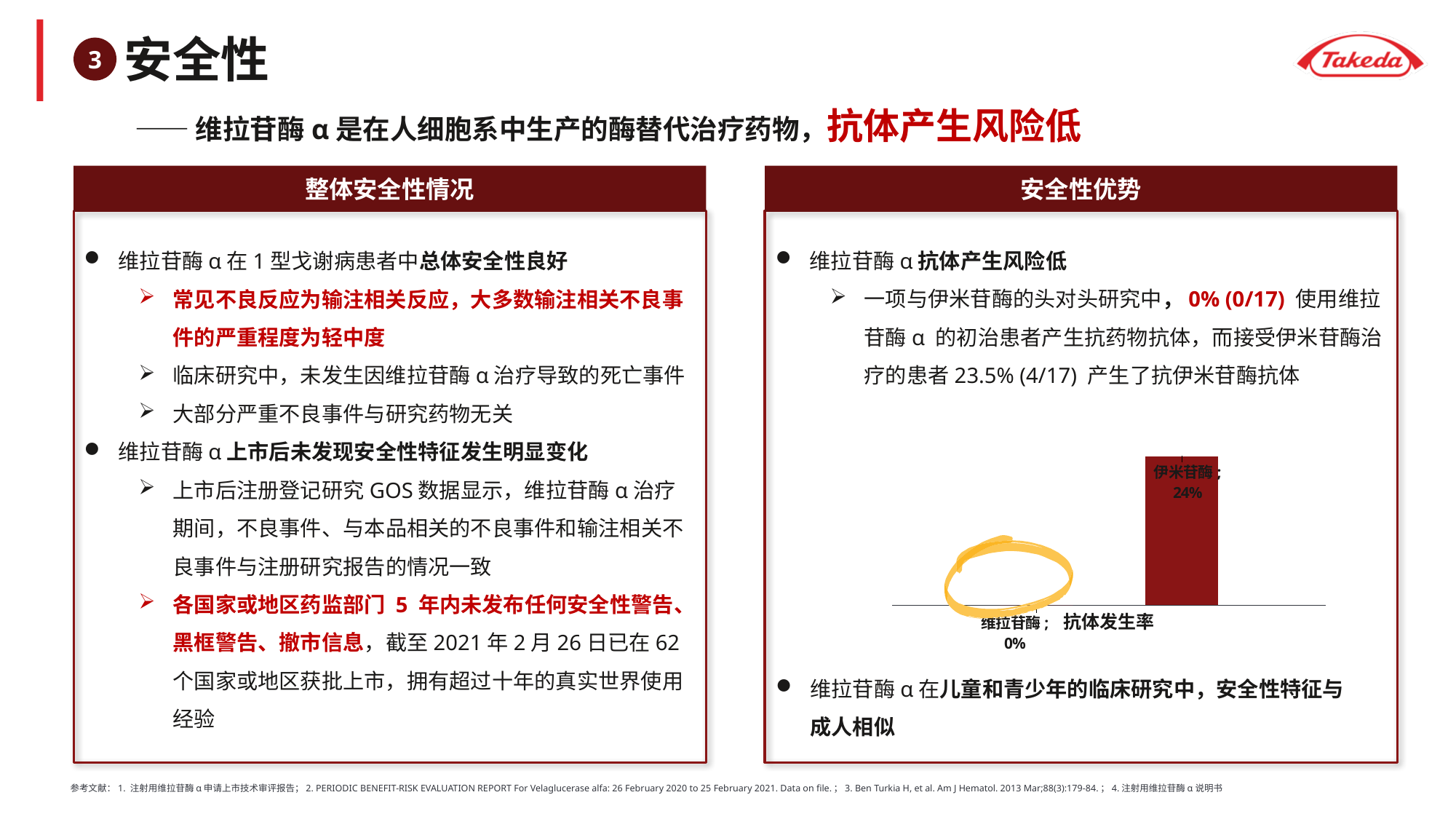
Which category in the chart has the lower antibody incidence rate? 维拉苷酶 What colour is the bar for 伊米苷酶 in the chart? dark red What is the difference between the antibody incidence rates of 伊米苷酶 and 维拉苷酶 in the chart? 24% What is the antibody incidence rate (抗体发生率) shown for 伊米苷酶 in the chart? 24% What quantity does the chart's axis label say is being plotted? 抗体发生率 What is the antibody incidence rate (抗体发生率) shown for 维拉苷酶 in the chart? 0% What kind of chart is shown on the slide? bar chart Which category in the chart has the higher antibody incidence rate? 伊米苷酶 Is the antibody incidence rate for 伊米苷酶 larger or smaller than that for 维拉苷酶? larger How many categories are plotted in the chart? 2